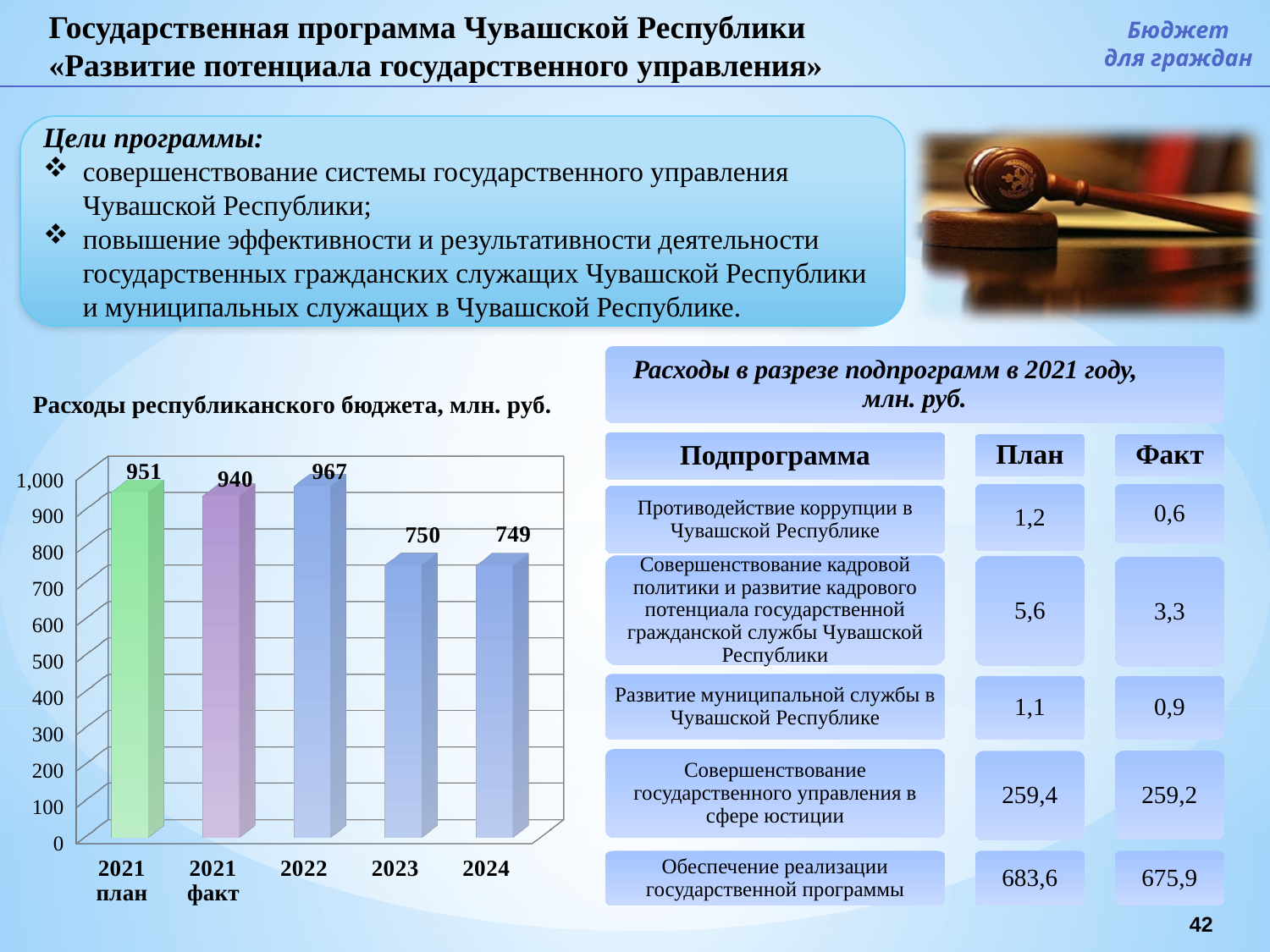
What kind of chart is shown on the slide? bar chart What is the value for 2024 in the chart? 749 What is the value for 2021 план in the chart? 951 How many categories are shown on the x axis of the chart? 5 What is the value for 2021 факт in the chart? 940 What is the difference between the values for 2021 план and 2021 факт? 11 Which category has the highest value in the chart? 2022 What is the value for 2022 in the chart "Расходы республиканского бюджета, млн. руб."? 967 Is the value for 2023 greater or less than 800? less Which is larger, the value for 2021 факт or the value for 2023? 2021 факт What is the difference between the values for 2022 and 2023? 217 Which category has the lowest value in the chart? 2024